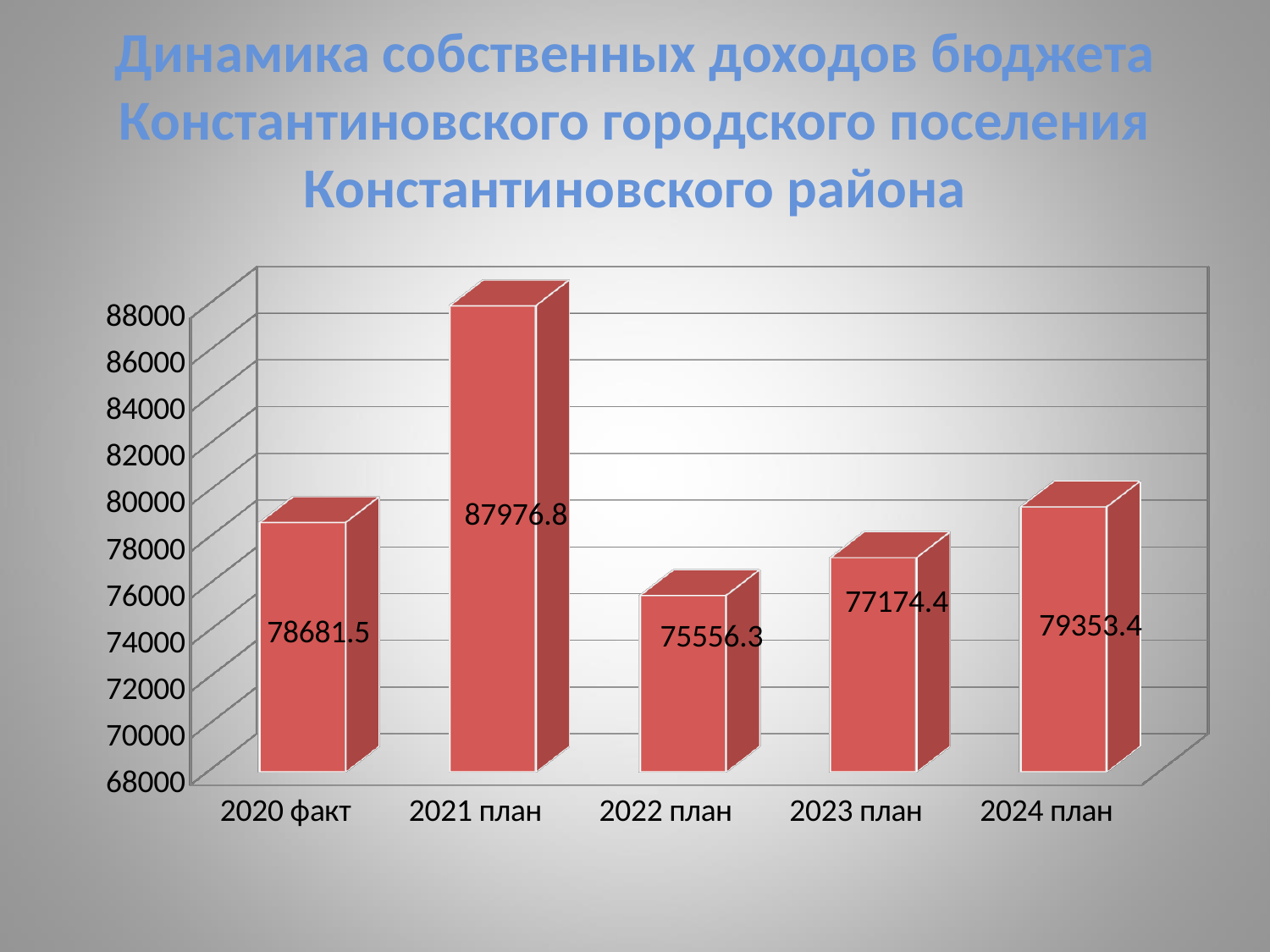
What is the value for 2024 план? 79353.4 How many categories are shown on the x axis? 5 What is the value for 2021 план? 87976.8 Which category has the highest value? 2021 план Which is larger, the value for 2023 план or the value for 2024 план? 2024 план Which category has the lowest value? 2022 план What is the difference between the values for 2021 план and 2020 факт? 9295.3 What kind of chart is shown on the slide? bar chart Is the value for 2021 план greater or less than 84000? greater What is the value for 2020 факт? 78681.5 What is the difference between the values for 2024 план and 2022 план? 3797.1 What is the value for 2022 план? 75556.3